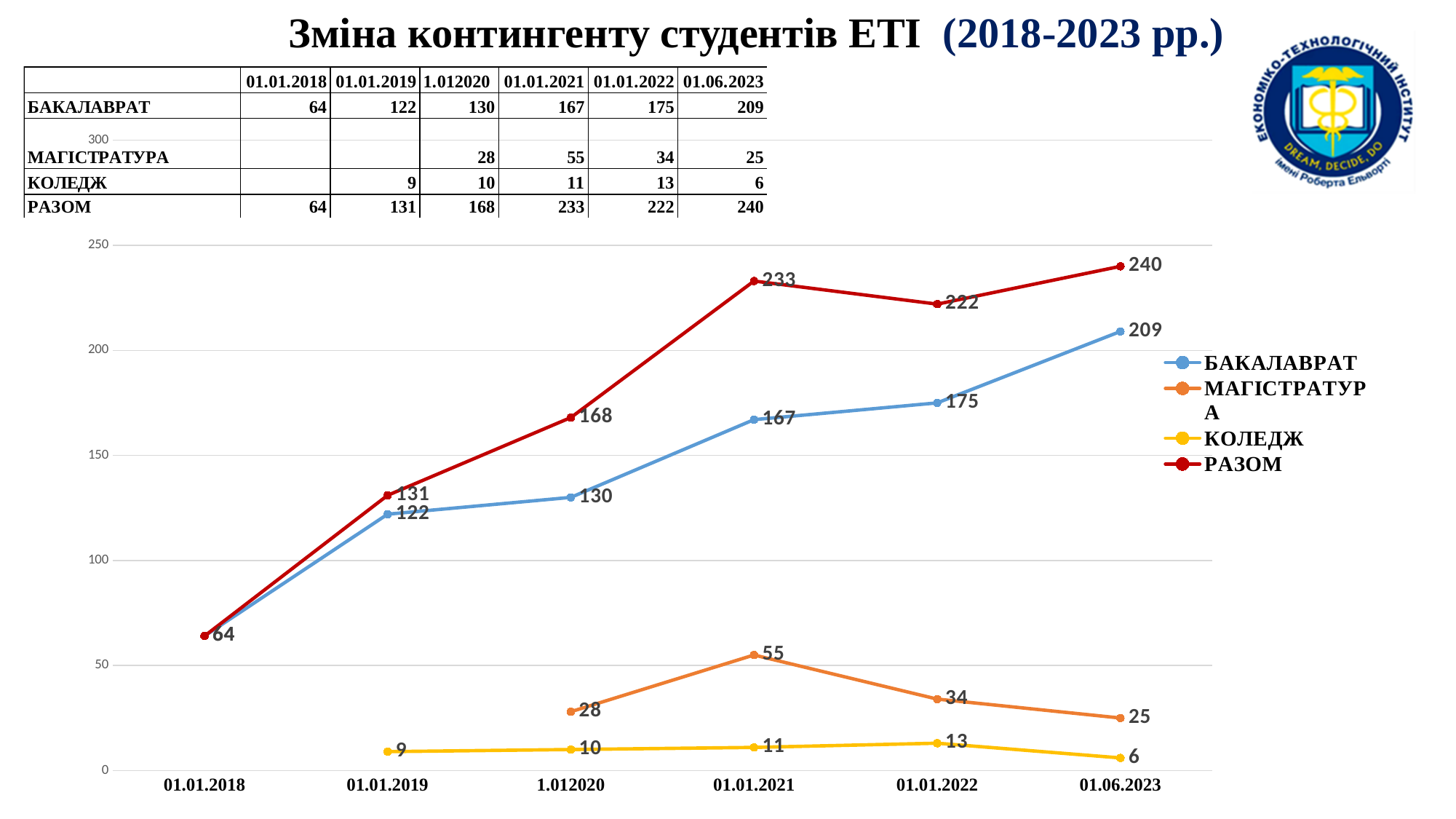
Which is larger on 01.01.2020: the value of МАГІСТРАТУРА or the value of КОЛЕДЖ? МАГІСТРАТУРА On which date does the КОЛЕДЖ series have its lowest value? 01.06.2023 How many dates are shown along the x axis of the chart? 6 Does the БАКАЛАВРАТ series rise or fall from 01.01.2018 to 01.06.2023? rise What is the value of РАЗОМ on 01.01.2022? 222 What type of chart is shown on the slide? line chart What colour is the line for the РАЗОМ series? red What is the value of БАКАЛАВРАТ on 01.06.2023? 209 On which date does the РАЗОМ series reach its highest value? 01.06.2023 What is the difference between the РАЗОМ values on 01.01.2021 and 01.01.2022? 11 How many series does the chart legend list? 4 What is the value of МАГІСТРАТУРА on 01.01.2021? 55